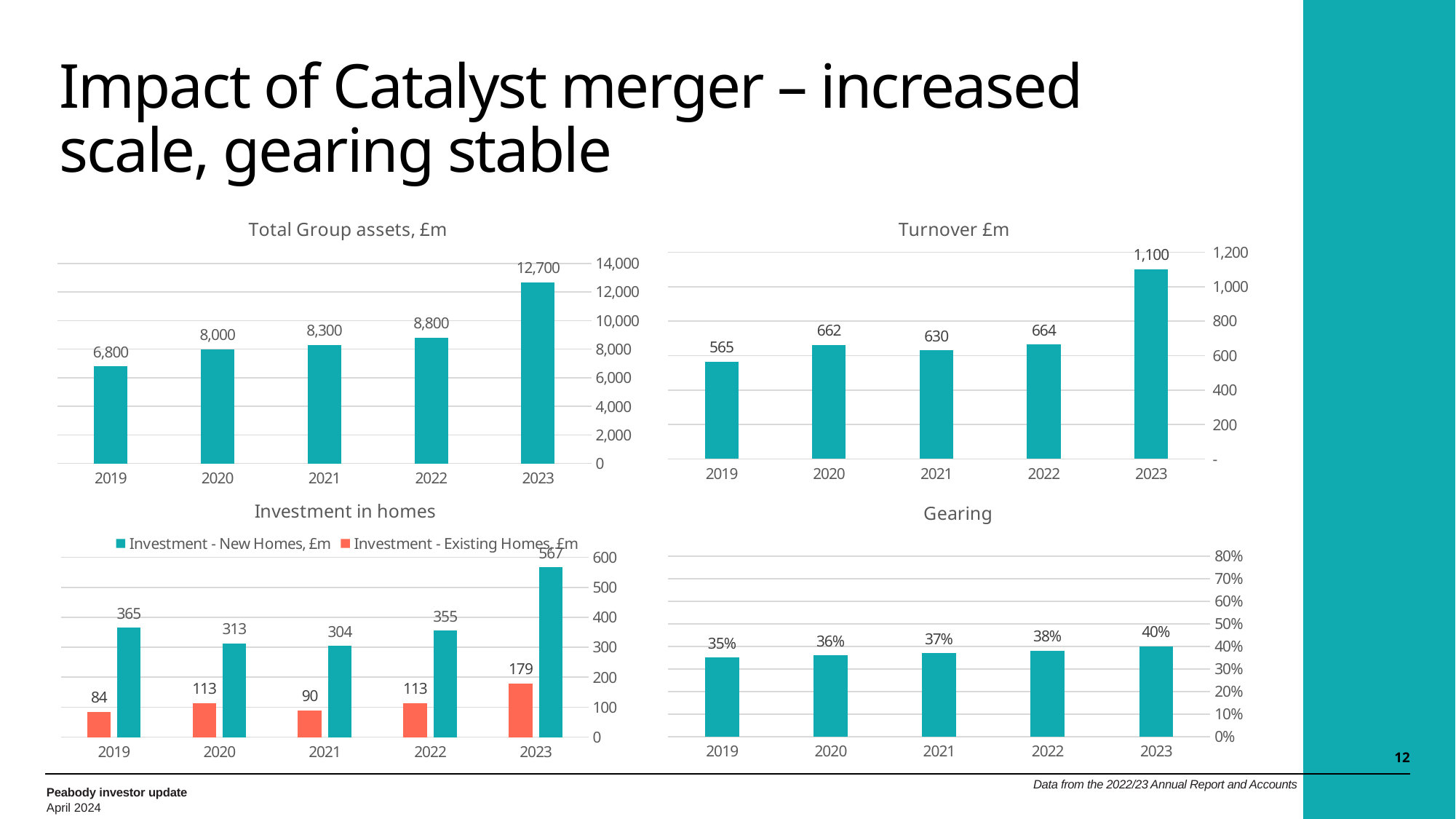
In the 'Turnover £m' chart, which year has the highest turnover? 2023 In the 'Investment in homes' chart, what is the difference between Investment - New Homes and Investment - Existing Homes in 2019? 281 In the 'Turnover £m' chart, what is the value for 2021? 630 In the 'Investment in homes' chart, how many series does the legend list? 2 In the 'Investment in homes' chart, what is the value for Investment - Existing Homes, £m in 2023? 179 In the 'Turnover £m' chart, is the value for 2020 larger or smaller than the value for 2021? larger In the 'Gearing' chart, what is the value for 2022? 38% In the 'Total Group assets, £m' chart, what is the value for 2023? 12,700 In the 'Total Group assets, £m' chart, which year has the lowest value? 2019 In the 'Total Group assets, £m' chart, what is the difference between the 2023 and 2022 values? 3,900 What kind of chart is the 'Gearing' chart? bar chart In the 'Gearing' chart, do the values rise or fall from 2019 to 2023? rise